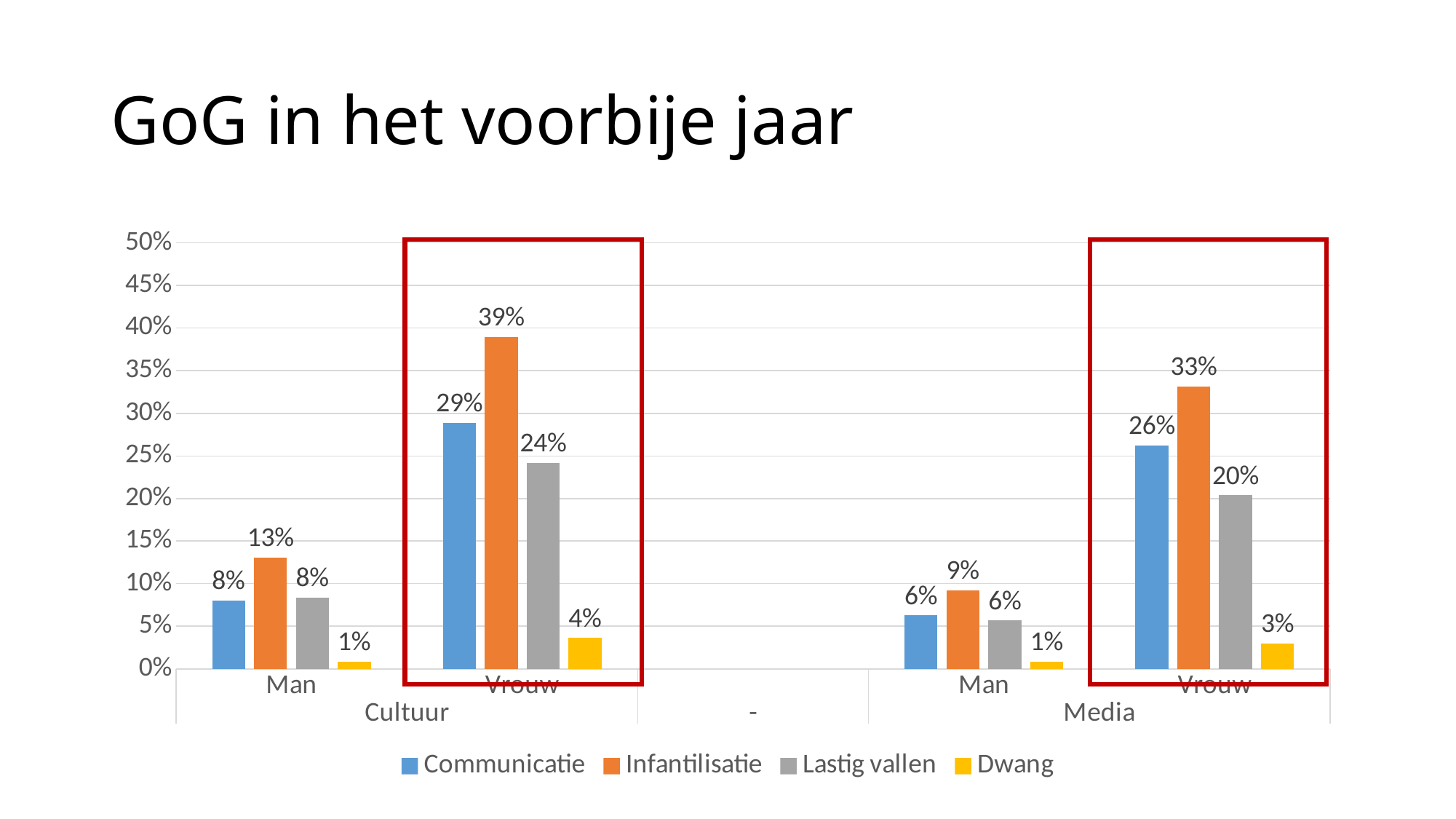
What is the title of the slide? GoG in het voorbije jaar What is the value for Communicatie for Man in the Media group? 6% How many series does the legend list? 4 What is the difference between the Infantilisatie values for Vrouw in Cultuur and Vrouw in Media? 6% What is the difference between the Infantilisatie and Communicatie values for Man in the Cultuur group? 5% What is the value for Dwang for Vrouw in the Media group? 3% What kind of chart is shown on the slide? Bar chart Which series has the highest value for Vrouw in the Media group? Infantilisatie Which series has the lowest value for Man in the Cultuur group? Dwang What is the value for Infantilisatie for Vrouw in the Cultuur group? 39% What is the value for Lastig vallen for Vrouw in the Cultuur group? 24% Which is larger: Communicatie for Vrouw in Cultuur or Communicatie for Vrouw in Media? Communicatie for Vrouw in Cultuur